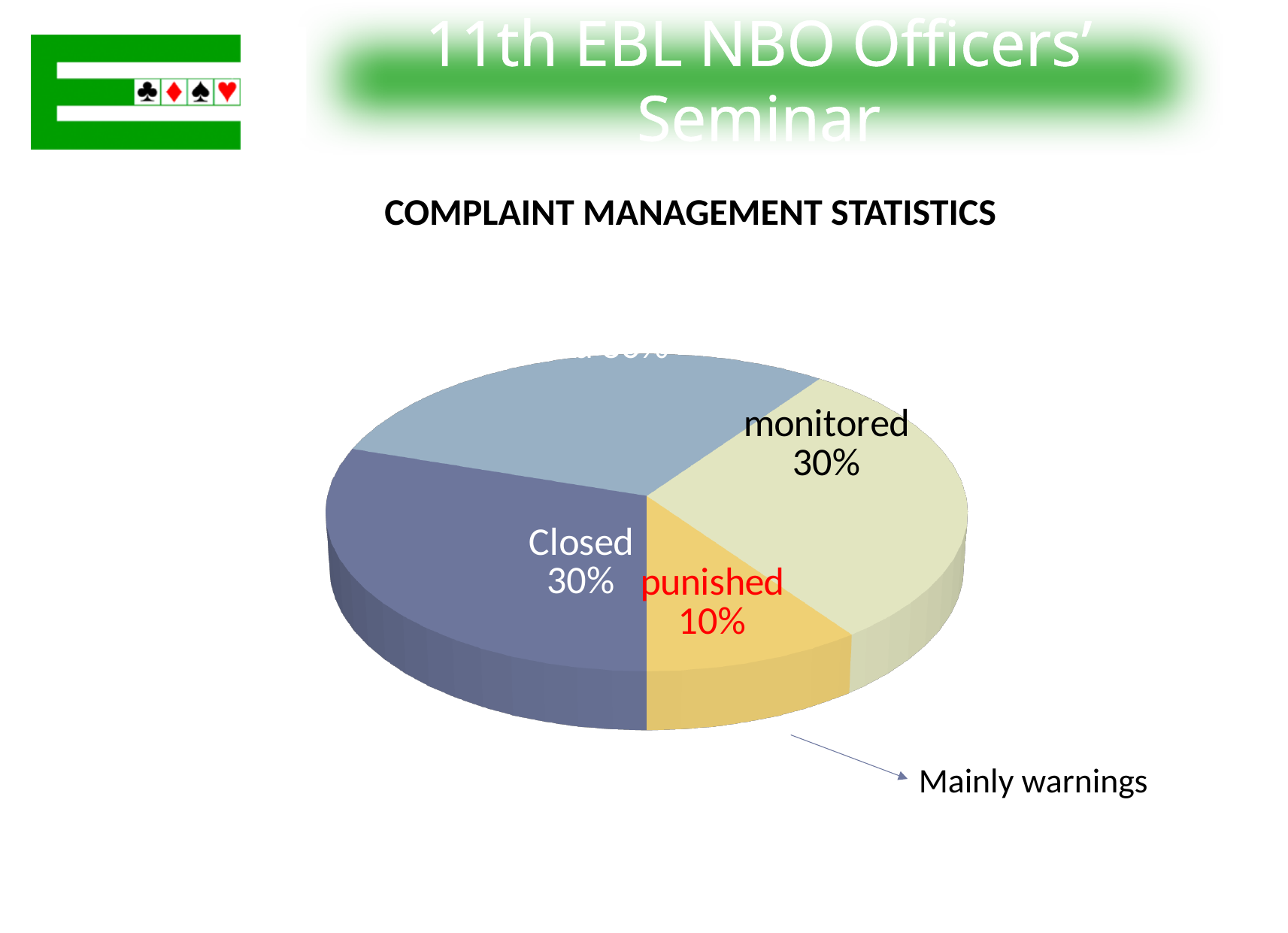
Which labelled slice of the pie chart has the smallest share? punished What is the title shown above the pie chart? COMPLAINT MANAGEMENT STATISTICS How many slices does the pie chart have? 4 What percentage of the pie chart is labelled monitored? 30% Which slice is larger, Closed or punished? Closed Which slice is larger, monitored or punished? monitored What kind of chart is shown on the slide? Pie chart What percentage of the pie chart is labelled Closed? 30% Which slice does the annotation "Mainly warnings" point to? punished What percentage of the pie chart is labelled punished? 10% By how many percentage points does the monitored slice exceed the punished slice? 20 percentage points By how many percentage points does the Closed slice exceed the punished slice? 20 percentage points